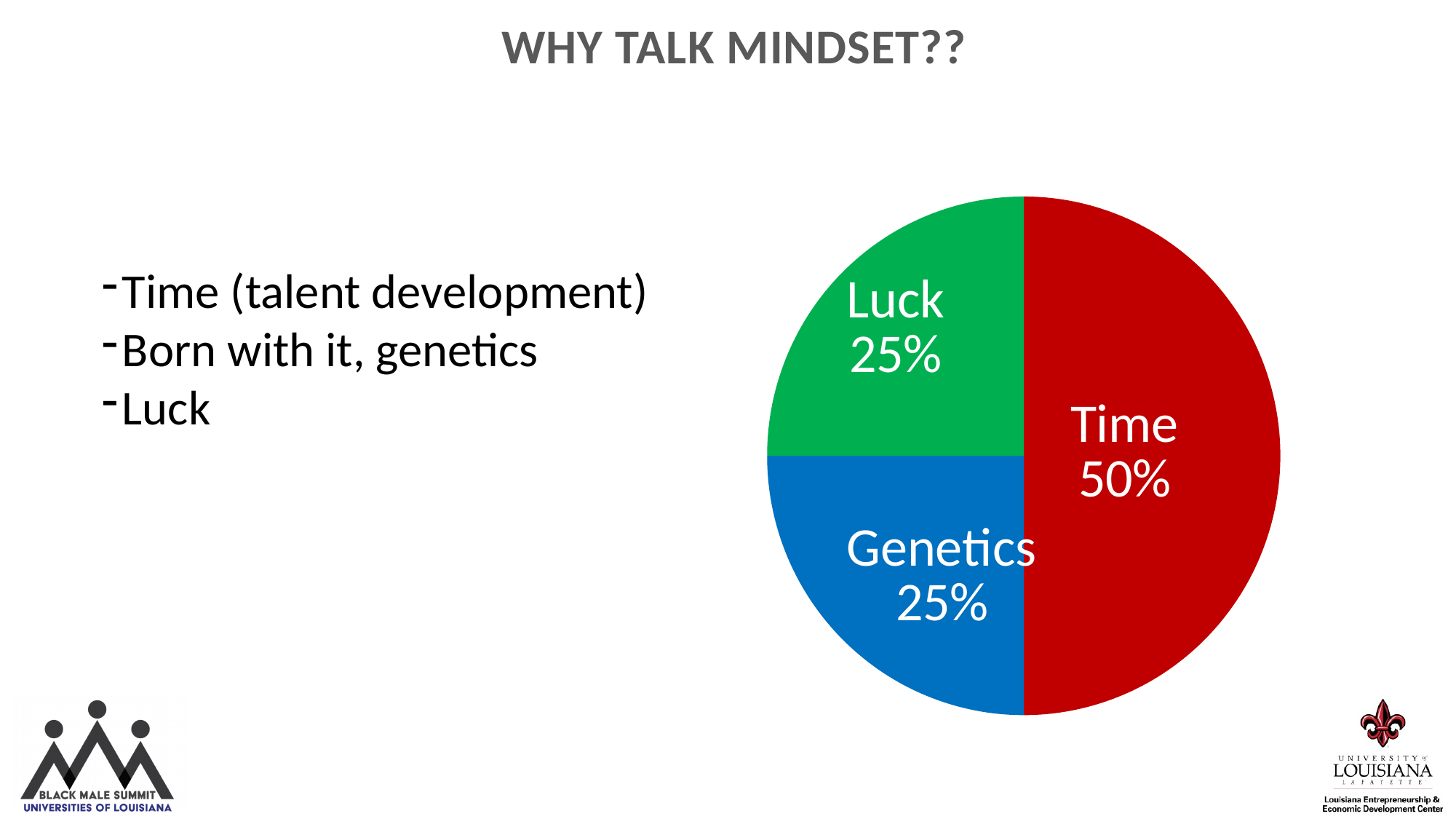
Which slice of the pie is the largest? Time How many slices does the pie chart have? 3 What colour is the Luck slice? green What is the difference between the Time share and the Luck share? 25% What share of the pie does Genetics have? 25% What is the combined share of Luck and Genetics? 50% What kind of chart is shown on the slide? pie chart What share of the pie does Luck have? 25% What colour is the Time slice? red Which is larger, the Time slice or the Genetics slice? Time What share of the pie does Time have? 50%